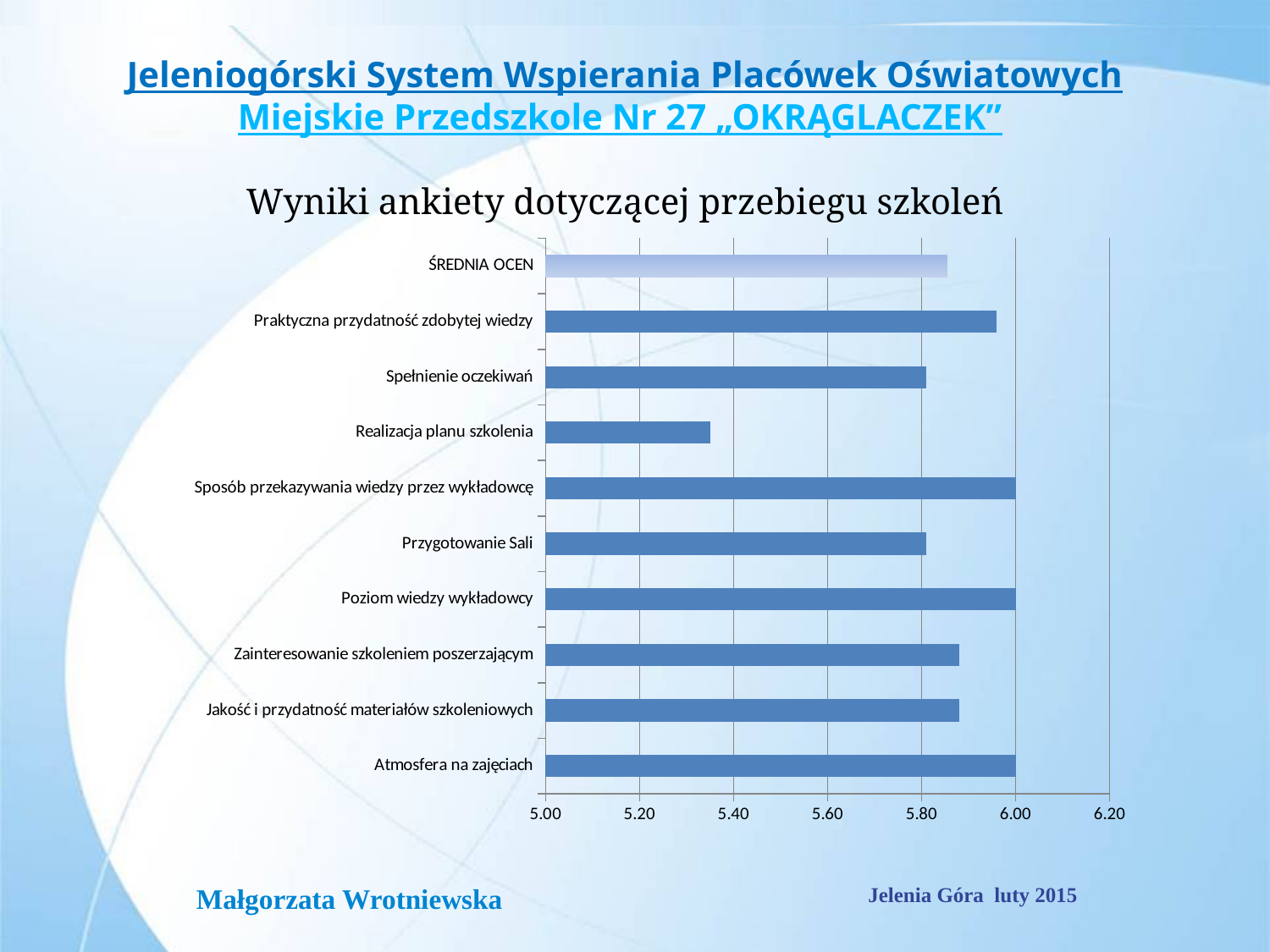
What is the value for Atmosfera na zajęciach? 6.00 What is the title of the chart? Wyniki ankiety dotyczącej przebiegu szkoleń What kind of chart is shown on the slide? bar chart Is the value for Praktyczna przydatność zdobytej wiedzy greater or less than 5.80? greater Which bar is drawn in a different, lighter colour than the others? ŚREDNIA OCEN What is the value for Sposób przekazywania wiedzy przez wykładowcę? 6.00 How many categories are plotted in the chart? 10 Is the value for Zainteresowanie szkoleniem poszerzającym greater or less than 5.80? greater Is the value for Realizacja planu szkolenia greater or less than 5.40? less Which is larger, the value for Praktyczna przydatność zdobytej wiedzy or the value for Realizacja planu szkolenia? Praktyczna przydatność zdobytej wiedzy Which category has the lowest value in the chart? Realizacja planu szkolenia What is the value for Poziom wiedzy wykładowcy? 6.00